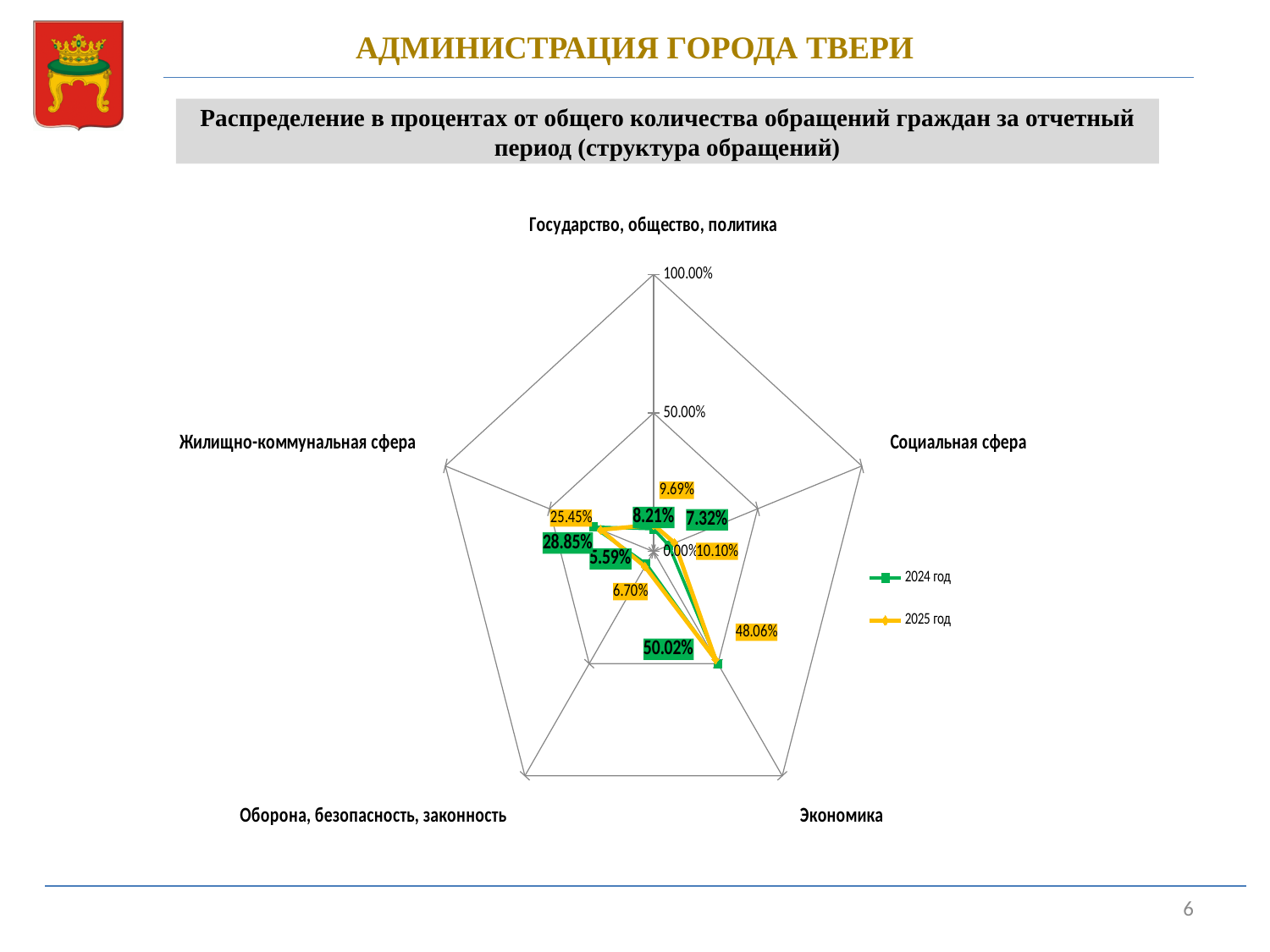
What is the value for Экономика in the 2025 год series? 48.06% Which category has the lowest value in the 2025 год series? Оборона, безопасность, законность Which category has the highest value in the 2024 год series? Экономика What is the value for Социальная сфера in the 2024 год series? 7.32% What is the difference between the 2024 год and 2025 год values for Жилищно-коммунальная сфера? 3.40% What is the value for Жилищно-коммунальная сфера in the 2025 год series? 25.45% How many series does the legend list? 2 What kind of chart is shown on the slide? radar chart How many categories (axes) does the radar chart have? 5 What is the value for Экономика in the 2024 год series? 50.02% Which series is drawn in green? 2024 год Which is larger for Государство, общество, политика: the 2024 год value or the 2025 год value? 2025 год